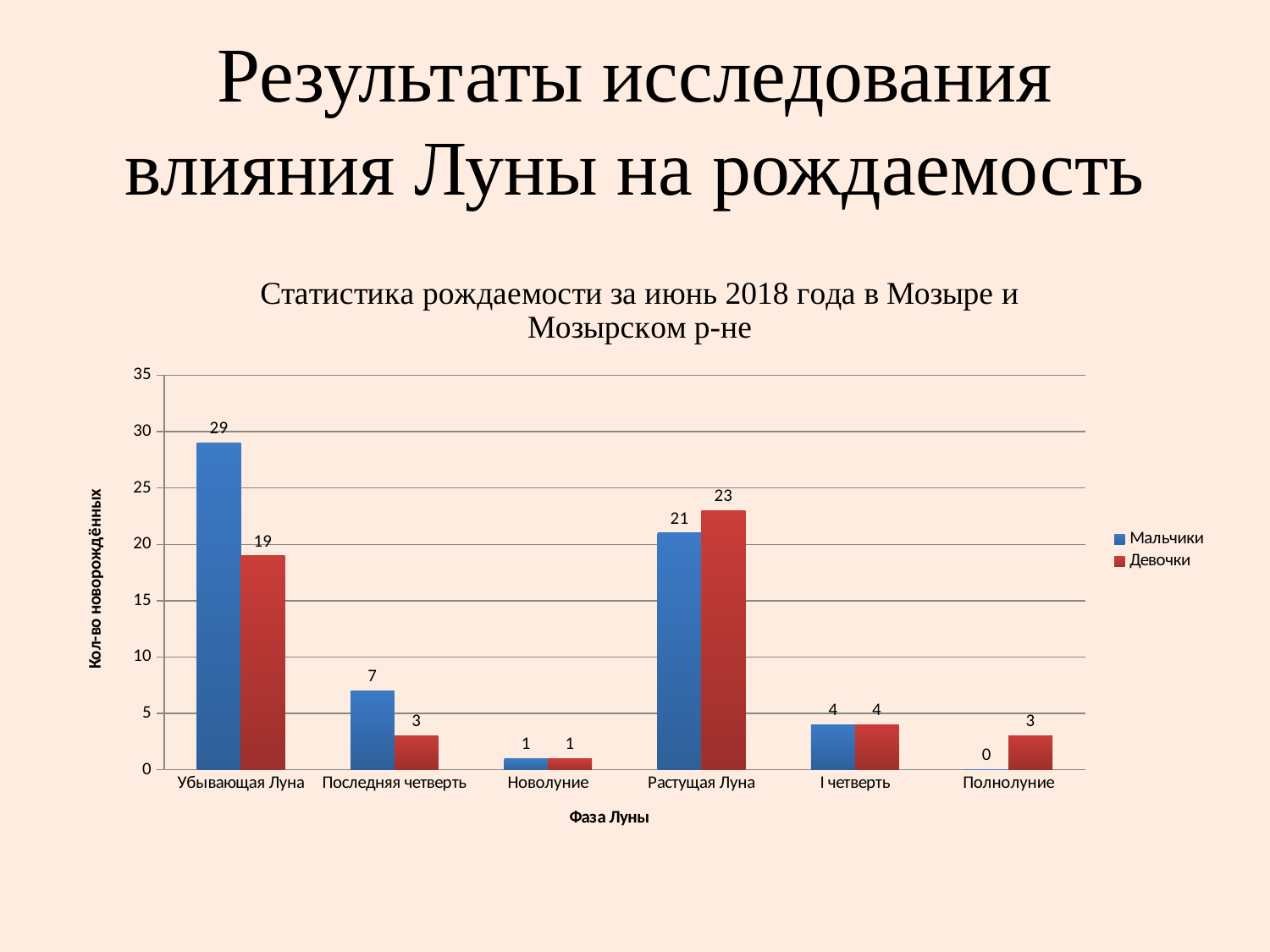
What is the value for Девочки in the Растущая Луна category? 23 What is the difference between Мальчики and Девочки in the Убывающая Луна category? 10 What is the value for Мальчики in the Убывающая Луна category? 29 Is the value for Девочки in the Растущая Луна category greater or less than 20? greater How many categories are shown on the x axis? 6 What kind of chart is shown on the slide? bar chart Which category has the highest value for Мальчики? Убывающая Луна What is the value for Мальчики in the Полнолуние category? 0 Which category has the lowest value for Девочки? Новолуние Which is larger in the Последняя четверть category, Мальчики or Девочки? Мальчики How many series does the legend list? 2 What is the label of the x axis? Фаза Луны